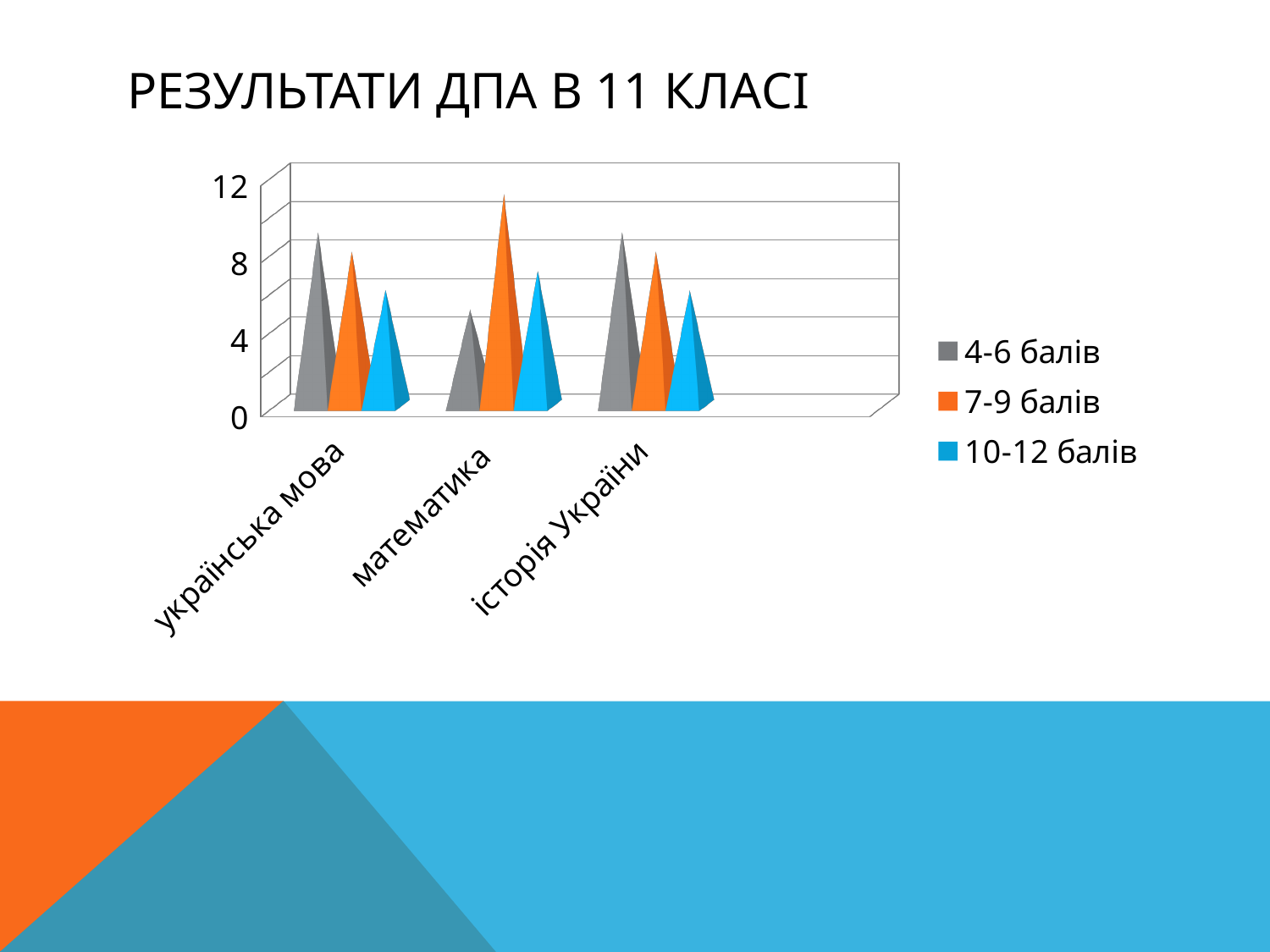
Is the value for 10-12 балів in історія України greater or less than 8? less How many subject categories are shown on the x axis? 3 Which subject has the highest value for 7-9 балів? математика What is the title of the chart on the slide? РЕЗУЛЬТАТИ ДПА В 11 КЛАСІ Which subject has the lowest value for 4-6 балів? математика What kind of chart is shown on the slide? bar chart Is the value for 4-6 балів in математика greater or less than 8? less Is the value for 10-12 балів in українська мова greater or less than 8? less Which series is shown in orange in the legend? 7-9 балів How many series does the legend list? 3 For математика, which is larger: 7-9 балів or 4-6 балів? 7-9 балів